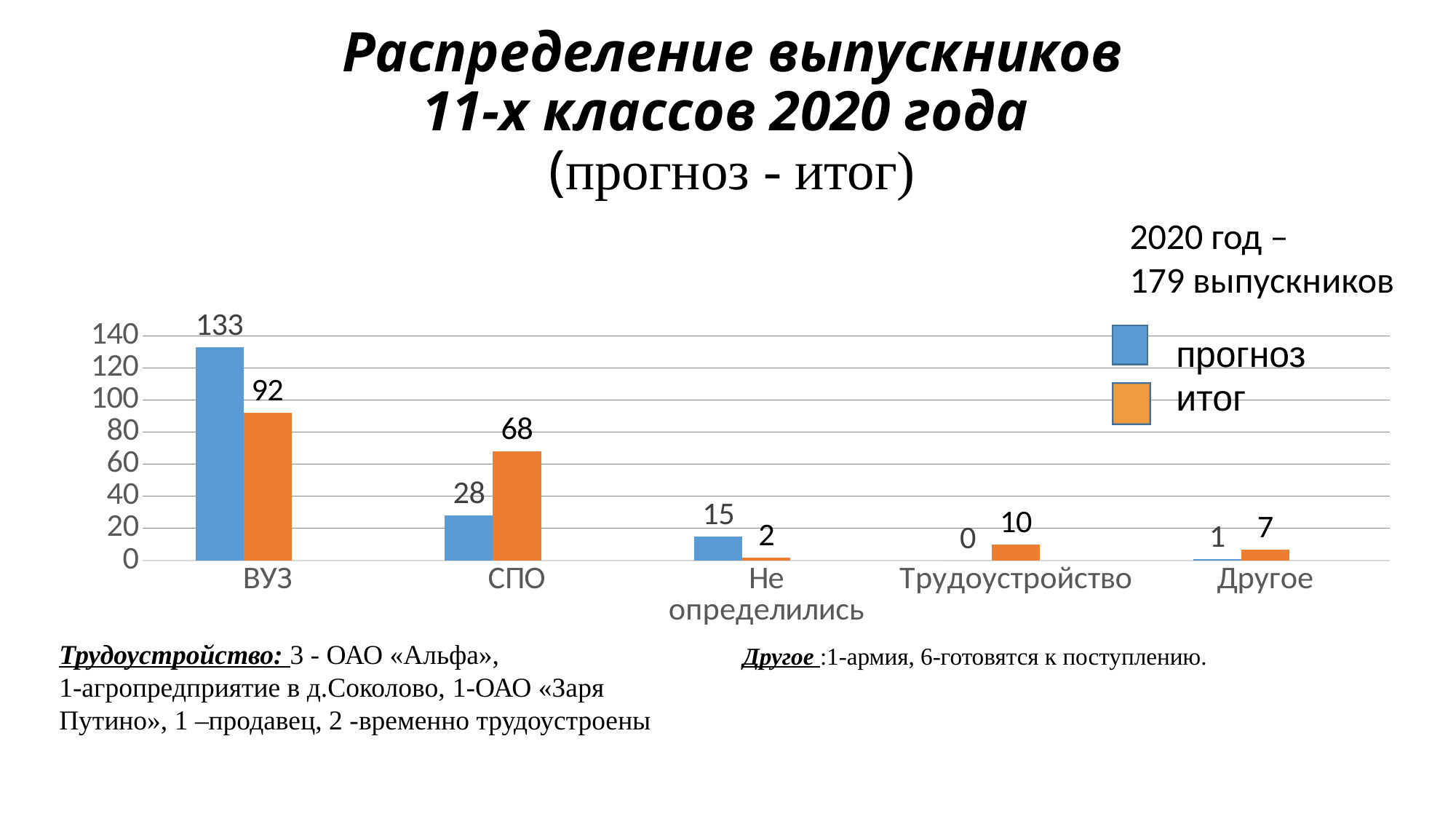
What is the итог value for СПО? 68 What is the difference between the прогноз and итог values for ВУЗ? 41 How many series does the legend list? 2 Which category has the lowest итог value? Не определились What is the прогноз value for ВУЗ? 133 How many categories are shown on the x axis? 5 Which category has the highest прогноз value? ВУЗ What is the итог value for Трудоустройство? 10 What is the прогноз value for Не определились? 15 Which is larger for СПО, the прогноз value or the итог value? итог What kind of chart is shown on the slide? bar chart Which colour represents the итог series in the legend? orange